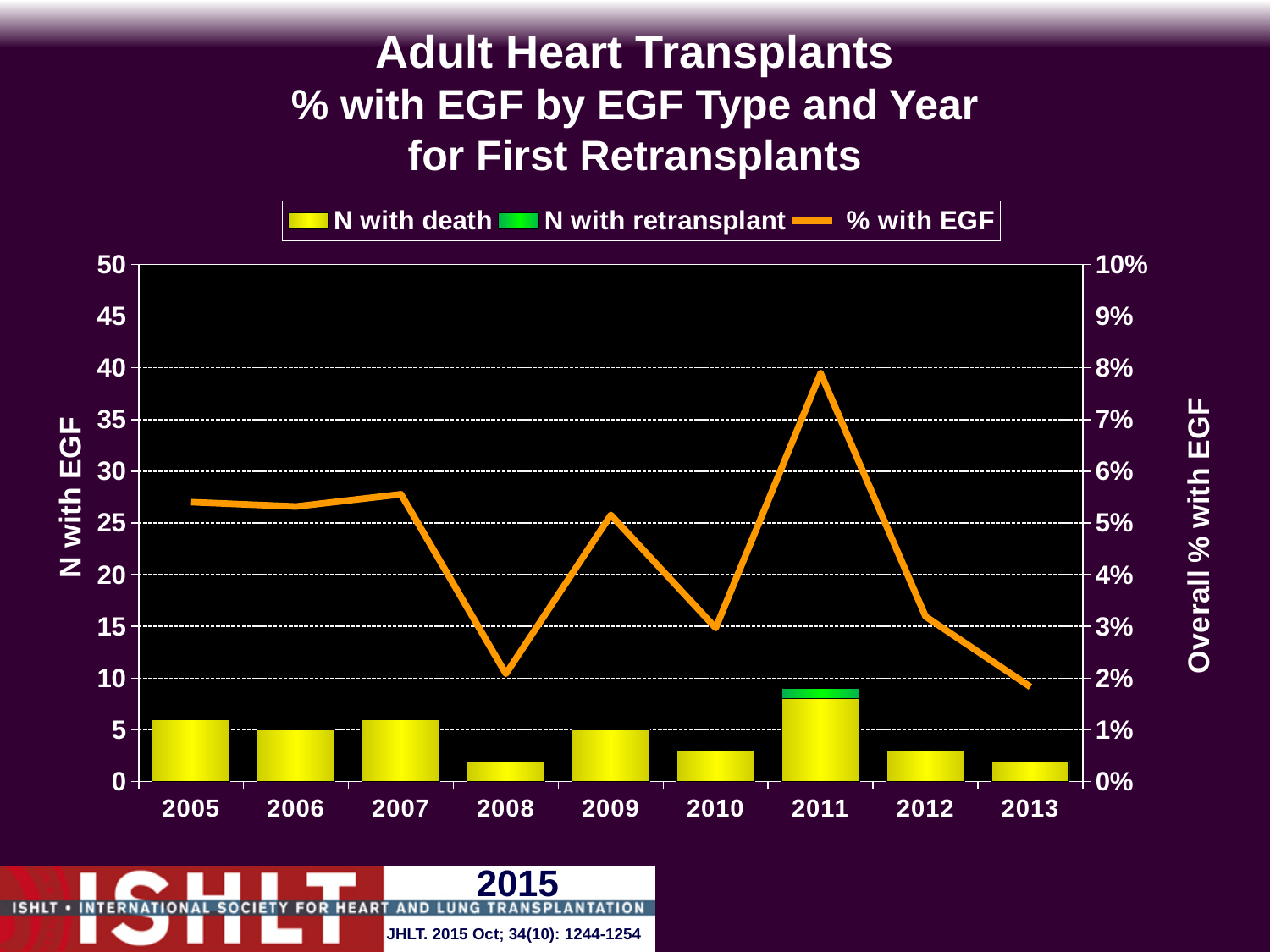
In which year is the % with EGF line at its highest? 2011 Does the % with EGF line rise or fall from 2011 to 2013? It falls Is the % with EGF value for 2011 greater or less than 7%? greater How many series does the legend list? 3 What kind of chart is shown on the slide? A combined bar and line chart How many years are shown on the x axis? 9 Which year has the larger % with EGF, 2010 or 2011? 2011 In which year is a green N with retransplant segment visible on the bar? 2011 Is the % with EGF value for 2008 greater or less than 3%? less Is the N with death value for 2008 greater or less than 5? less In which year is the N with death bar the tallest? 2011